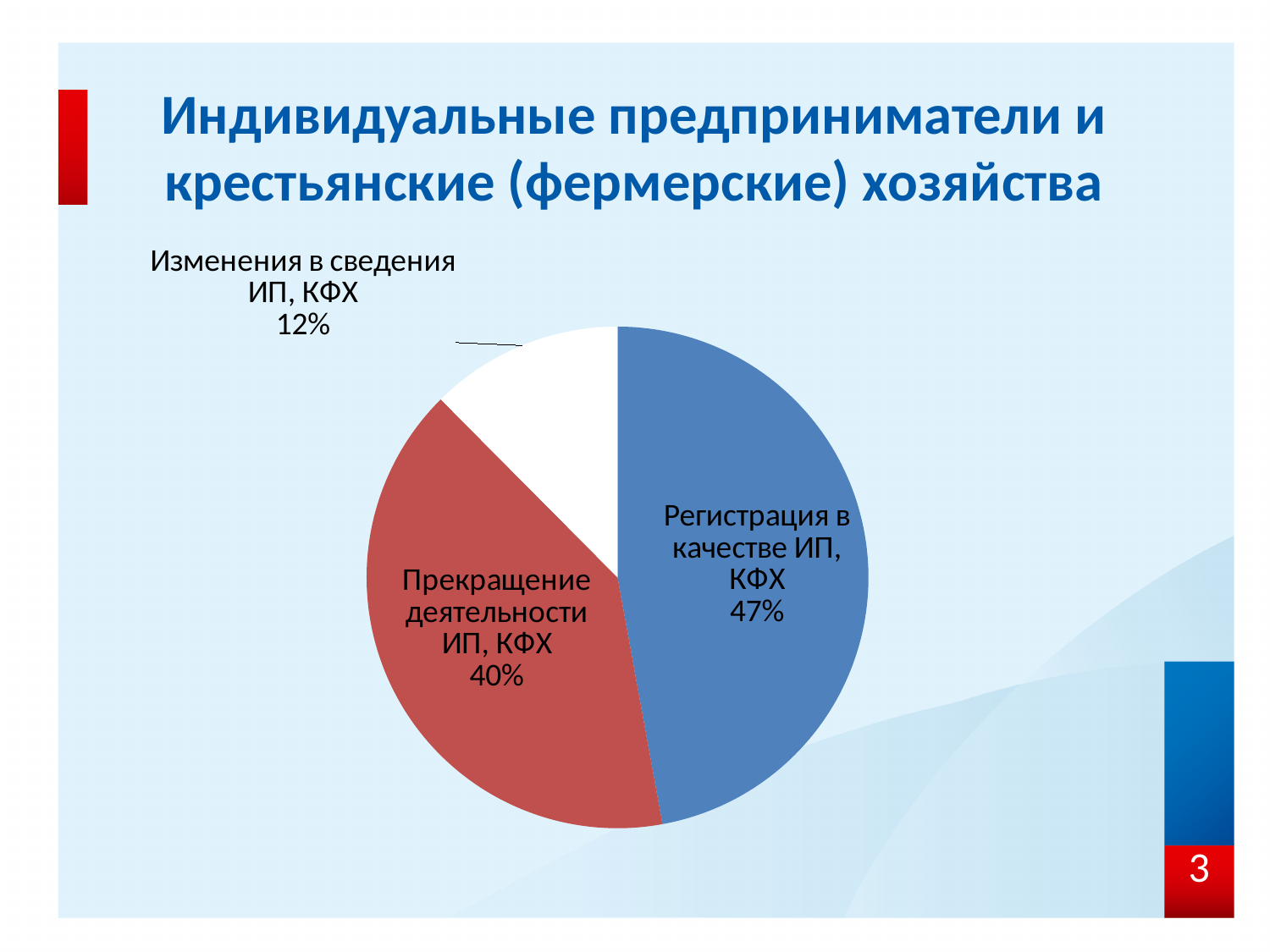
Which slice of the pie is the largest? Регистрация в качестве ИП, КФХ What is the difference in percentage points between "Прекращение деятельности ИП, КФХ" and "Изменения в сведения ИП, КФХ"? 28 What share of the pie is labelled "Изменения в сведения ИП, КФХ"? 12% Which is larger: the share for "Регистрация в качестве ИП, КФХ" or the share for "Прекращение деятельности ИП, КФХ"? Регистрация в качестве ИП, КФХ What share of the pie is labelled "Прекращение деятельности ИП, КФХ"? 40% Which slice of the pie is the smallest? Изменения в сведения ИП, КФХ What colour is the slice for "Прекращение деятельности ИП, КФХ"? red What is the difference in percentage points between "Регистрация в качестве ИП, КФХ" and "Прекращение деятельности ИП, КФХ"? 7 How many slices does the pie chart have? 3 What kind of chart is shown on the slide? pie chart What share of the pie is labelled "Регистрация в качестве ИП, КФХ"? 47% What is the title of the slide containing the pie chart? Индивидуальные предприниматели и крестьянские (фермерские) хозяйства